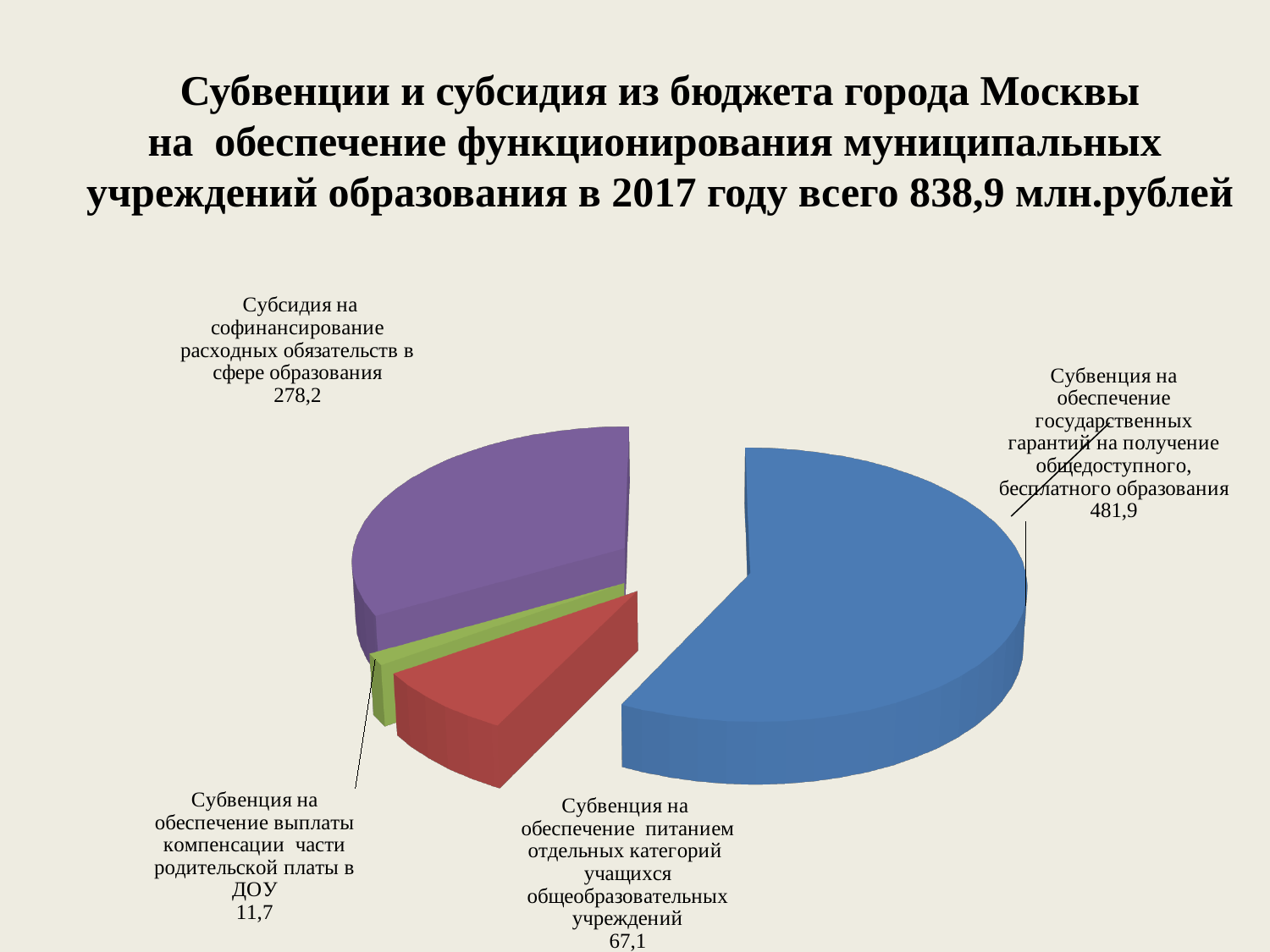
What type of chart is shown on the slide? pie chart What is the value for "Субвенция на обеспечение государственных гарантий на получение общедоступного, бесплатного образования"? 481,9 How many slices does the pie chart have? 4 What is the difference between the value for "Субвенция на обеспечение государственных гарантий..." (481,9) and "Субсидия на софинансирование расходных обязательств в сфере образования" (278,2)? 203,7 Which category has the smallest slice of the pie? Субвенция на обеспечение выплаты компенсации части родительской платы в ДОУ What is the value for "Субвенция на обеспечение выплаты компенсации части родительской платы в ДОУ"? 11,7 Which is larger: the value for "Субвенция на обеспечение питанием отдельных категорий учащихся" or the value for "Субвенция на обеспечение выплаты компенсации части родительской платы в ДОУ"? Субвенция на обеспечение питанием отдельных категорий учащихся According to the slide title, what is the total amount of subventions and subsidies in 2017? 838,9 млн.рублей What is the value for "Субвенция на обеспечение питанием отдельных категорий учащихся общеобразовательных учреждений"? 67,1 Which category has the largest slice of the pie? Субвенция на обеспечение государственных гарантий на получение общедоступного, бесплатного образования What is the value for "Субсидия на софинансирование расходных обязательств в сфере образования"? 278,2 What colour is the slice for "Субсидия на софинансирование расходных обязательств в сфере образования"? purple